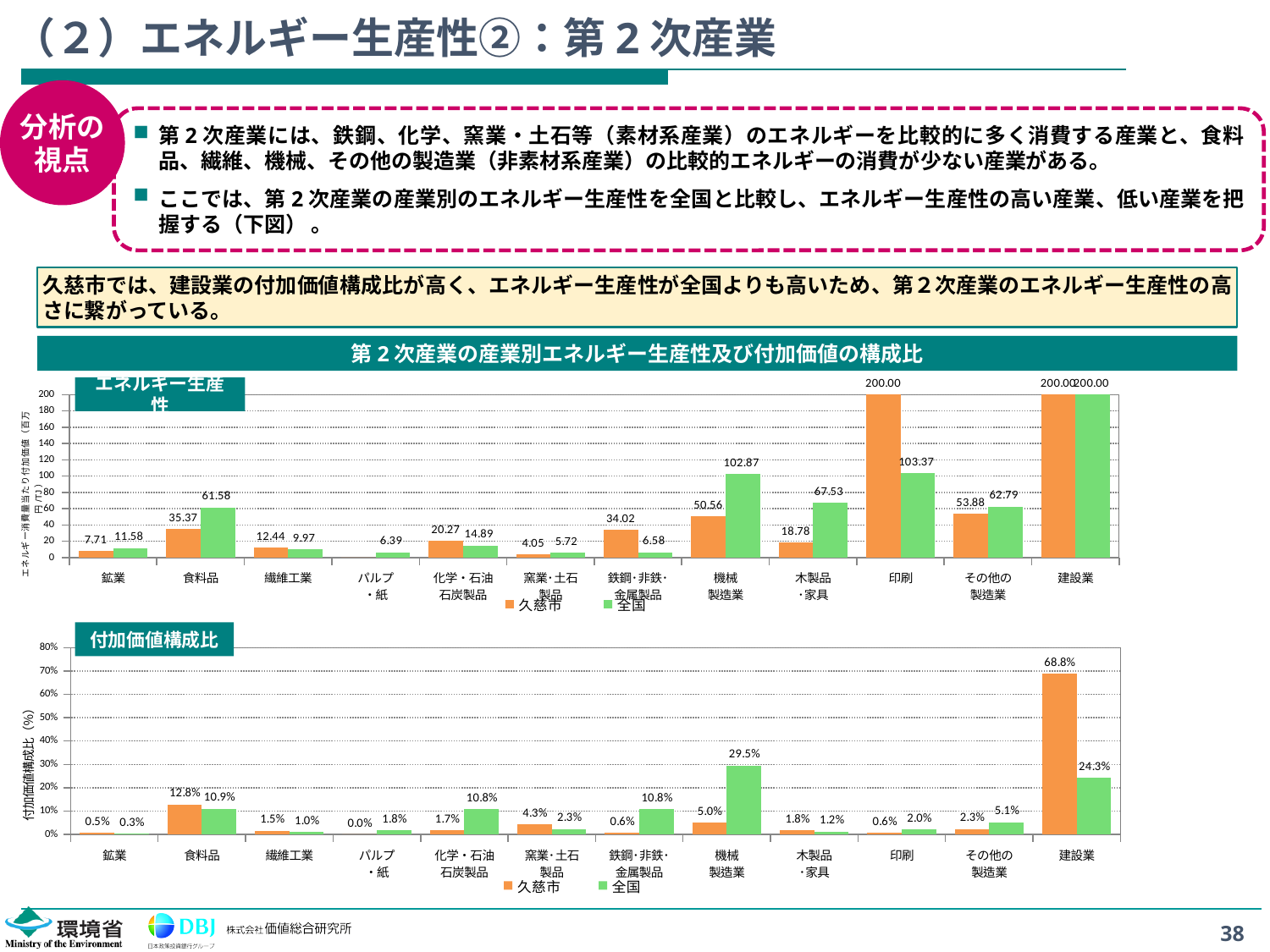
In the bottom chart (付加価値構成比), which category has the lowest value for 久慈市? パルプ・紙 In the bottom chart (付加価値構成比), what is the value for 久慈市 in the 建設業 category? 68.8% In the top chart (エネルギー生産性), what is the value for 全国 in the 機械製造業 category? 102.87 In the top chart (エネルギー生産性), is the 全国 value for 印刷 greater or less than 100? greater In the top chart (エネルギー生産性), which is larger for 鉄鋼・非鉄・金属製品: the 久慈市 value or the 全国 value? 久慈市 In the bottom chart (付加価値構成比), what is the difference between 久慈市 and 全国 for 建設業? 44.5% How many industry categories are shown on the x axis of the bottom chart (付加価値構成比)? 12 In the bottom chart (付加価値構成比), which category has the highest value for 全国? 機械製造業 In the top chart (エネルギー生産性), what is the difference between the 全国 value and the 久慈市 value for 木製品・家具? 48.75 In the top chart (エネルギー生産性), what is the value for 久慈市 in the 食料品 category? 35.37 What kind of chart is the bottom chart (付加価値構成比)? bar chart How many series does the legend of the top chart (エネルギー生産性) list? 2